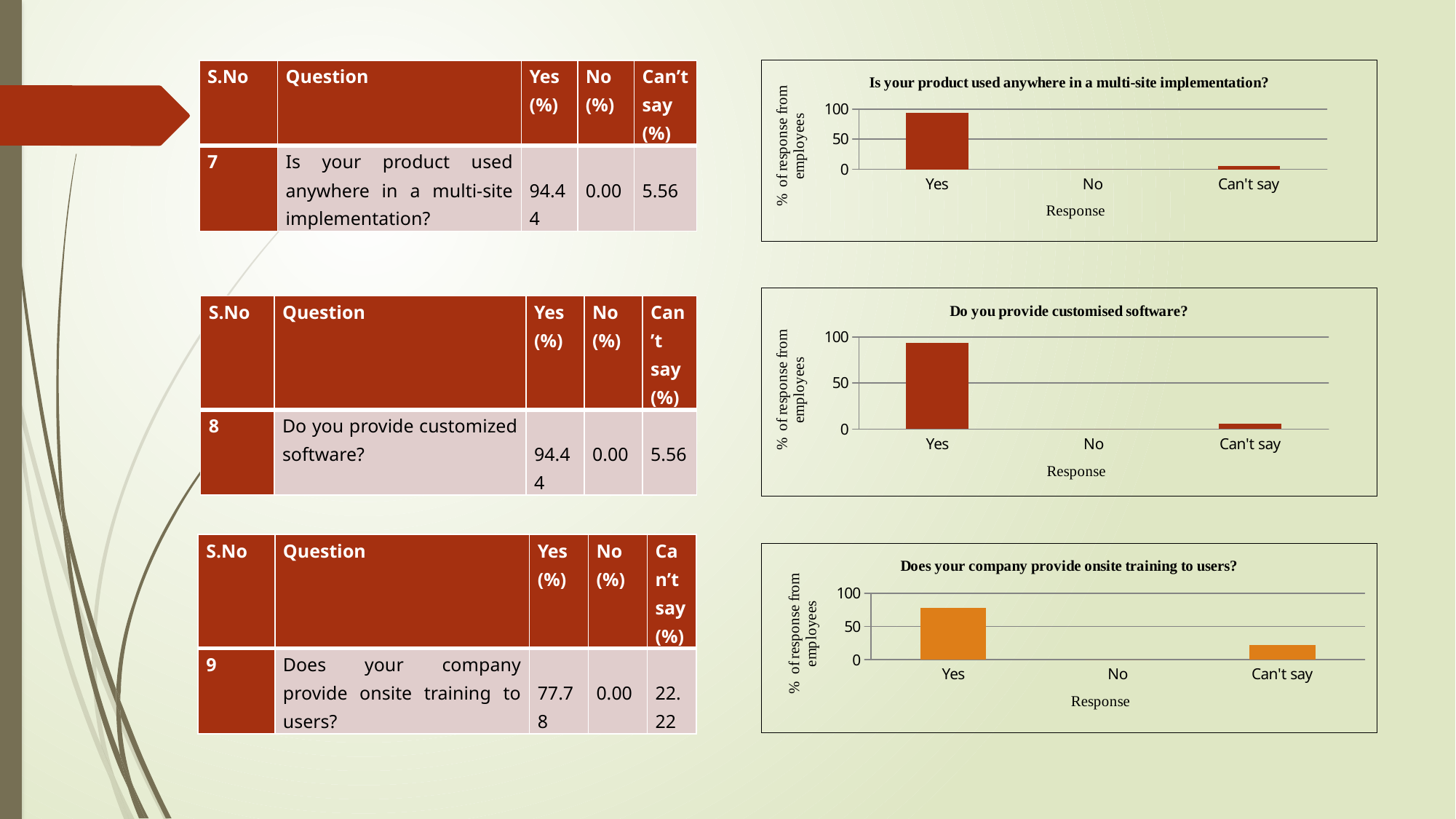
In the chart titled "Do you provide customised software?", is the value for Can't say greater or less than 50? less In the chart titled "Does your company provide onsite training to users?", is the value for Yes greater or less than 50? greater What is the x-axis title of the chart titled "Does your company provide onsite training to users?"? Response In the chart titled "Does your company provide onsite training to users?", which is larger, the value for Yes or the value for Can't say? Yes In the chart titled "Do you provide customised software?", which response category has the lowest value? No In the chart titled "Is your product used anywhere in a multi-site implementation?", which response category has the highest value? Yes What kind of chart is the chart titled "Is your product used anywhere in a multi-site implementation?"? bar chart How many response categories are shown on the x axis of the chart titled "Do you provide customised software?"? 3 In the chart titled "Does your company provide onsite training to users?", is the value for Can't say greater or less than 50? less According to the table for question 9, what is the Yes (%) value for "Does your company provide onsite training to users?"? 77.78 What is the y-axis title of the chart titled "Is your product used anywhere in a multi-site implementation?"? % of response from employees